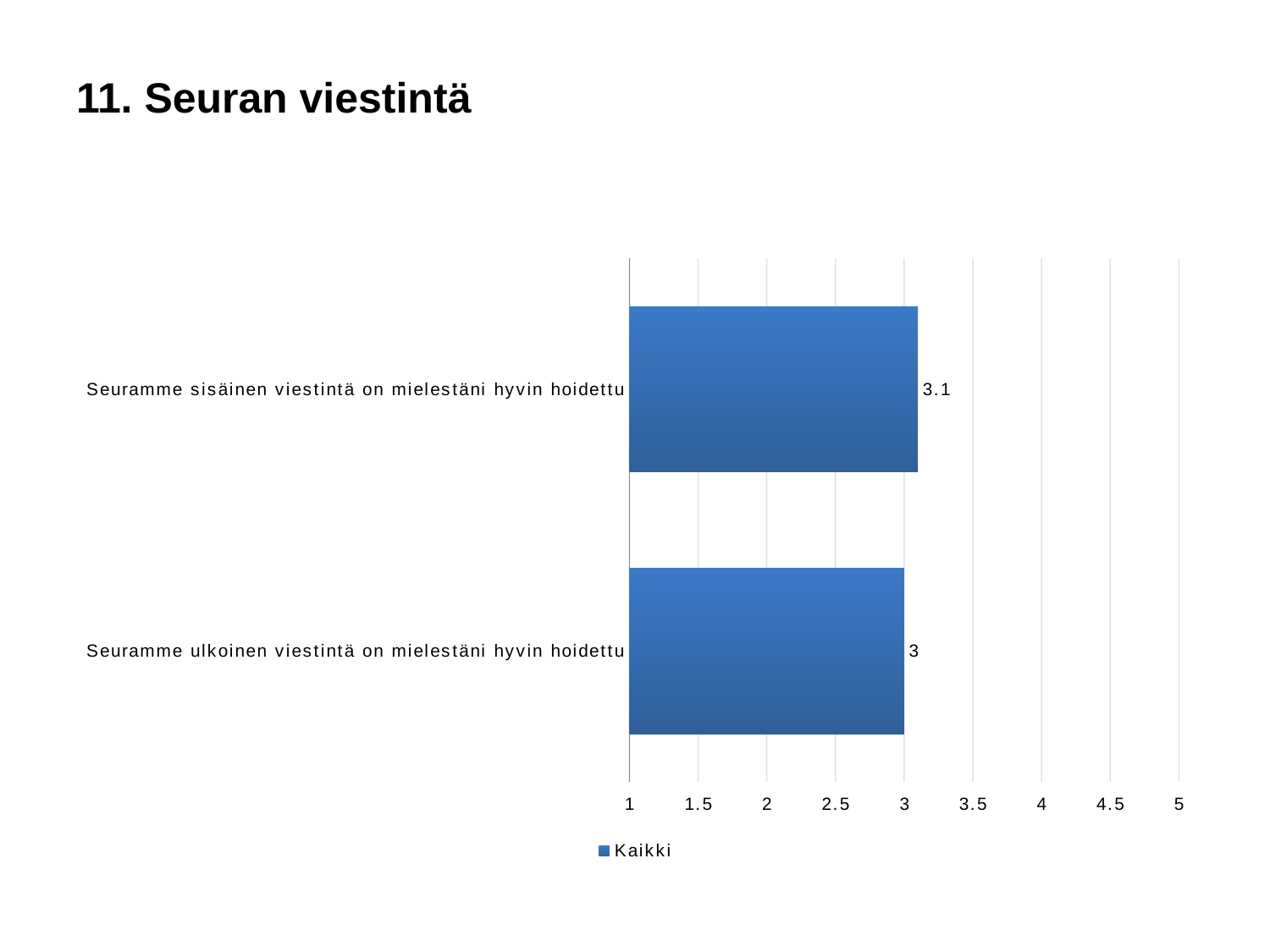
Which is larger: the value for "Seuramme sisäinen viestintä" or "Seuramme ulkoinen viestintä"? Seuramme sisäinen viestintä on mielestäni hyvin hoidettu Is the value for "Seuramme sisäinen viestintä on mielestäni hyvin hoidettu" greater or less than 4? less What is the value for "Seuramme sisäinen viestintä on mielestäni hyvin hoidettu"? 3.1 Is the value for "Seuramme ulkoinen viestintä on mielestäni hyvin hoidettu" greater or less than 2? greater What kind of chart is shown on the slide? bar chart Which category has the highest value? Seuramme sisäinen viestintä on mielestäni hyvin hoidettu Which category has the lowest value? Seuramme ulkoinen viestintä on mielestäni hyvin hoidettu How many categories are shown in the chart? 2 What is the value for "Seuramme ulkoinen viestintä on mielestäni hyvin hoidettu"? 3 What is the difference between the values for internal (sisäinen) and external (ulkoinen) communication? 0.1 What is the name of the series in the legend? Kaikki How many series does the legend list? 1